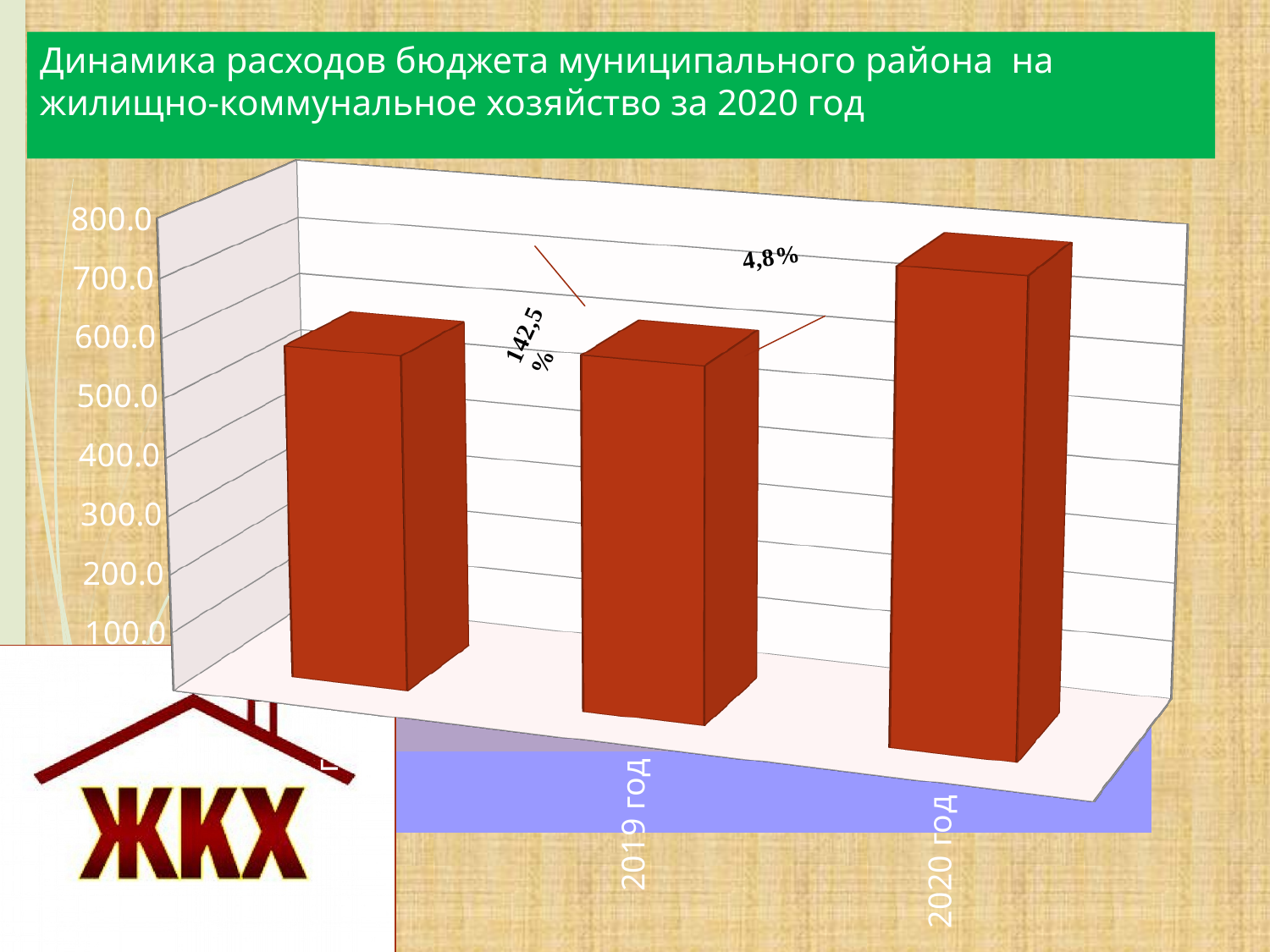
What kind of chart is shown on the slide? bar chart How many bars are plotted in the chart? 3 Is the value for 2019 год greater or less than 300? greater Which category has the highest bar in the chart? 2020 год Is the value for 2020 год greater or less than 500? greater Which bar is taller, 2019 год or 2020 год? 2020 год What percentage annotation is placed near the 2020 год bar? 4,8% What is the highest value shown on the vertical axis? 800.0 Is the value for 2019 год greater or less than 800? less